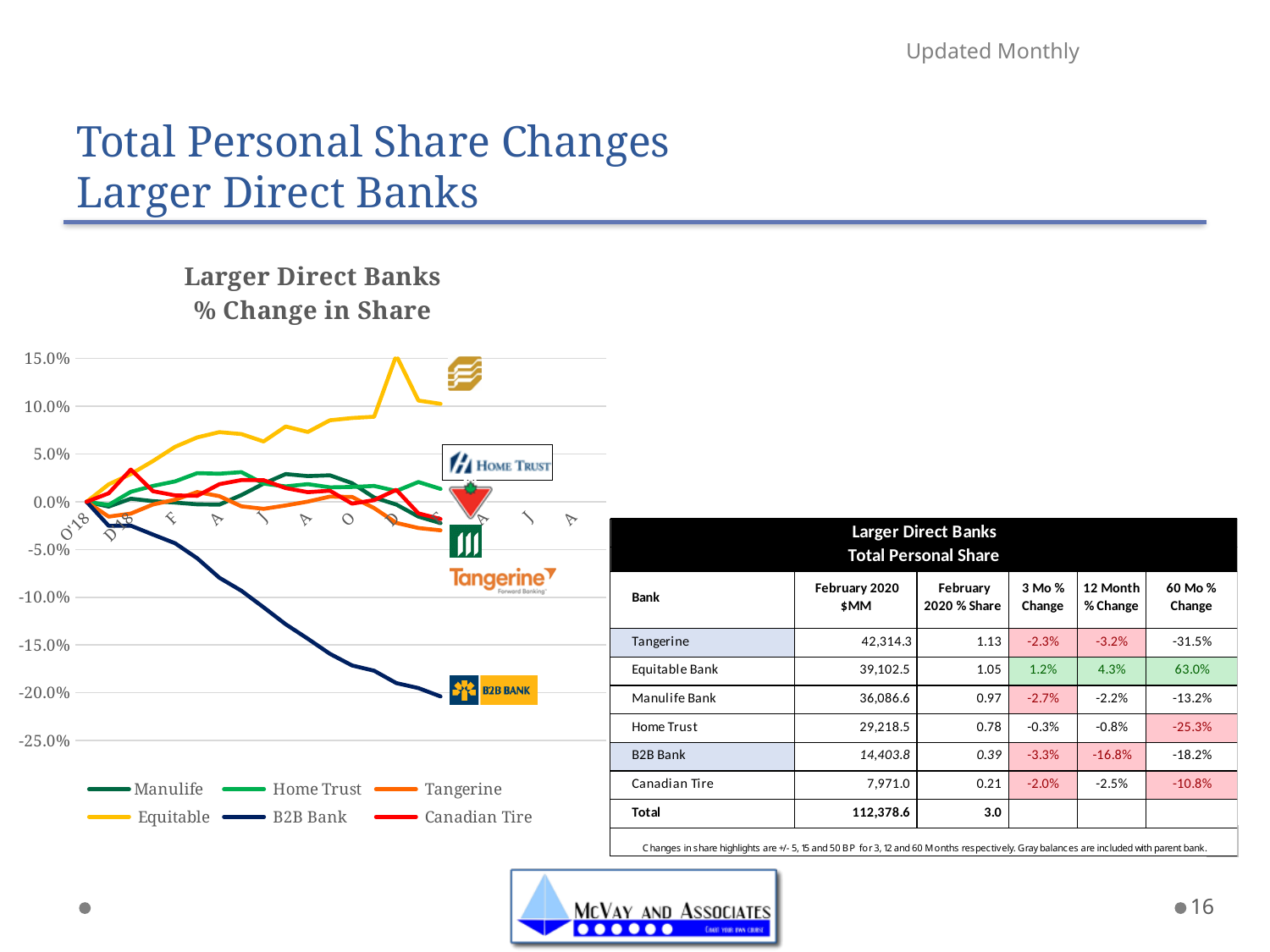
At the right end of the chart, which is larger: the value for Equitable or the value for Tangerine? Equitable Which series has the lowest value at the right end of the chart? B2B Bank Which series in the chart is plotted with a dark navy line? B2B Bank What is the title of the chart on the slide? Larger Direct Banks % Change in Share What kind of chart is shown on the slide? Line chart Which series has the highest value at the right end of the chart? Equitable Is the final value for B2B Bank greater or less than -15.0%? less How many series does the legend of the "Larger Direct Banks % Change in Share" chart list? 6 At the right end of the chart, which is larger: the value for Home Trust or the value for B2B Bank? Home Trust Is the peak value for Equitable greater or less than 10.0%? greater Does the Equitable line generally rise or fall over the period shown? Rise Does the B2B Bank line rise or fall over the period shown? Fall